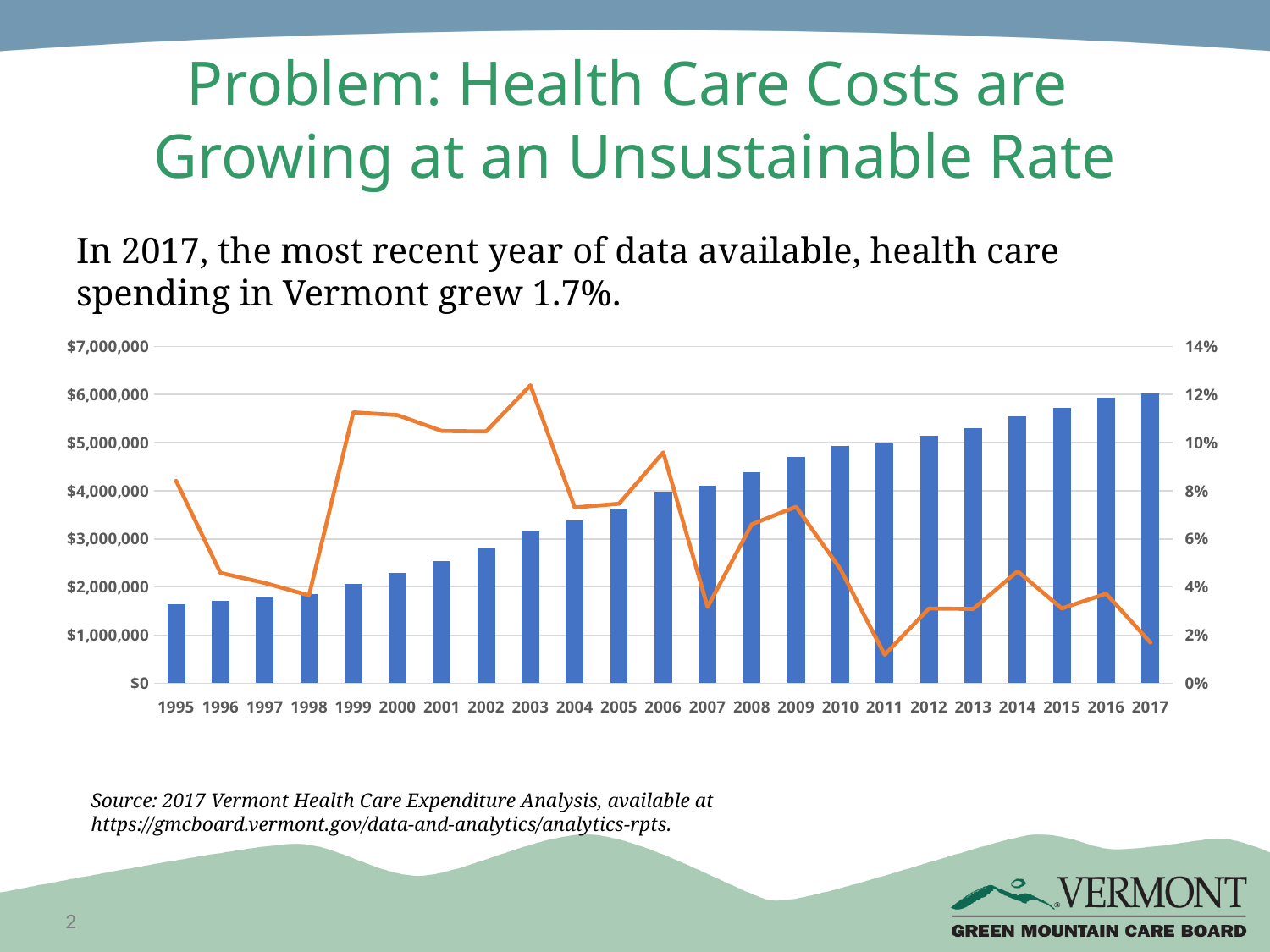
In which year does the orange line reach its highest point? 2003 Is the bar value for 2003 greater or less than $3,000,000? greater How many years are plotted along the x axis of the chart? 23 Is the orange line value for 1999 greater or less than 10%? greater Which year has the shortest bar in the chart? 1995 Is the orange line value for 2011 greater or less than 2%? less Which year has the tallest bar in the chart? 2017 Do the blue bars generally rise or fall from 1995 to 2017? Rise In which year does the orange line reach its lowest point? 2011 According to the slide, by what percentage did health care spending in Vermont grow in 2017? 1.7% What kind of chart is shown on the slide? A combined bar and line chart